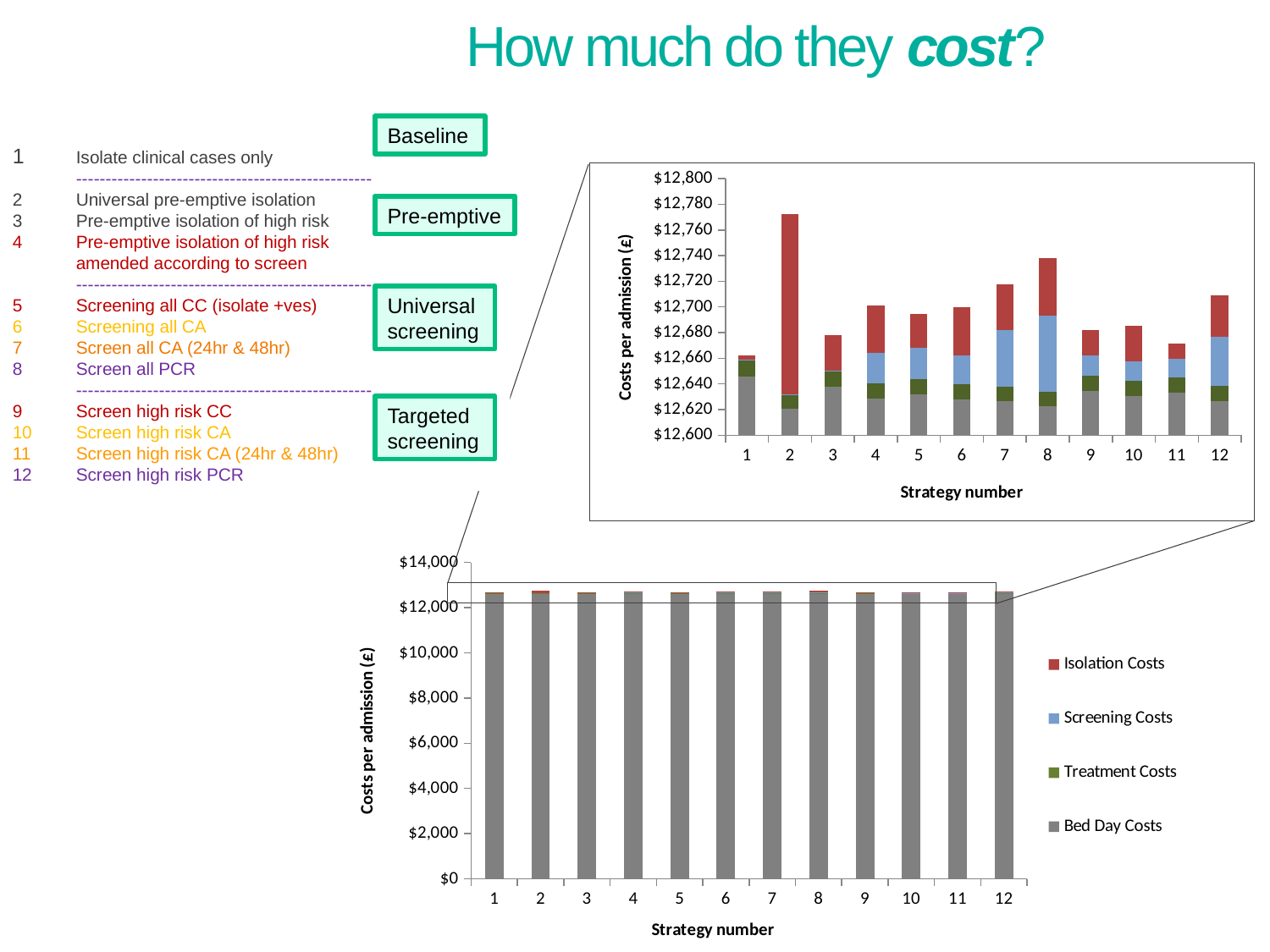
In the bottom chart, how many series does the legend list? 4 What is the y-axis title of the bottom chart? Costs per admission (£) In the bottom chart, is the total cost per admission for strategy 1 greater or less than $12,000? greater In the top-right chart, which has the larger total cost per admission, strategy 7 or strategy 4? Strategy 7 How many strategy numbers are plotted along the x axis of the top-right chart? 12 In the top-right chart, is the total cost per admission for strategy 8 greater or less than $12,720? greater In the bottom chart's legend, which series is shown in red? Isolation Costs In the top-right chart, which strategy number has the highest total cost per admission? 2 What kind of chart is the zoomed-in chart at the top right of the slide? Stacked bar chart In the top-right chart, is the total cost per admission for strategy 1 greater or less than $12,680? less In the top-right chart, which has the larger total cost per admission, strategy 2 or strategy 8? Strategy 2